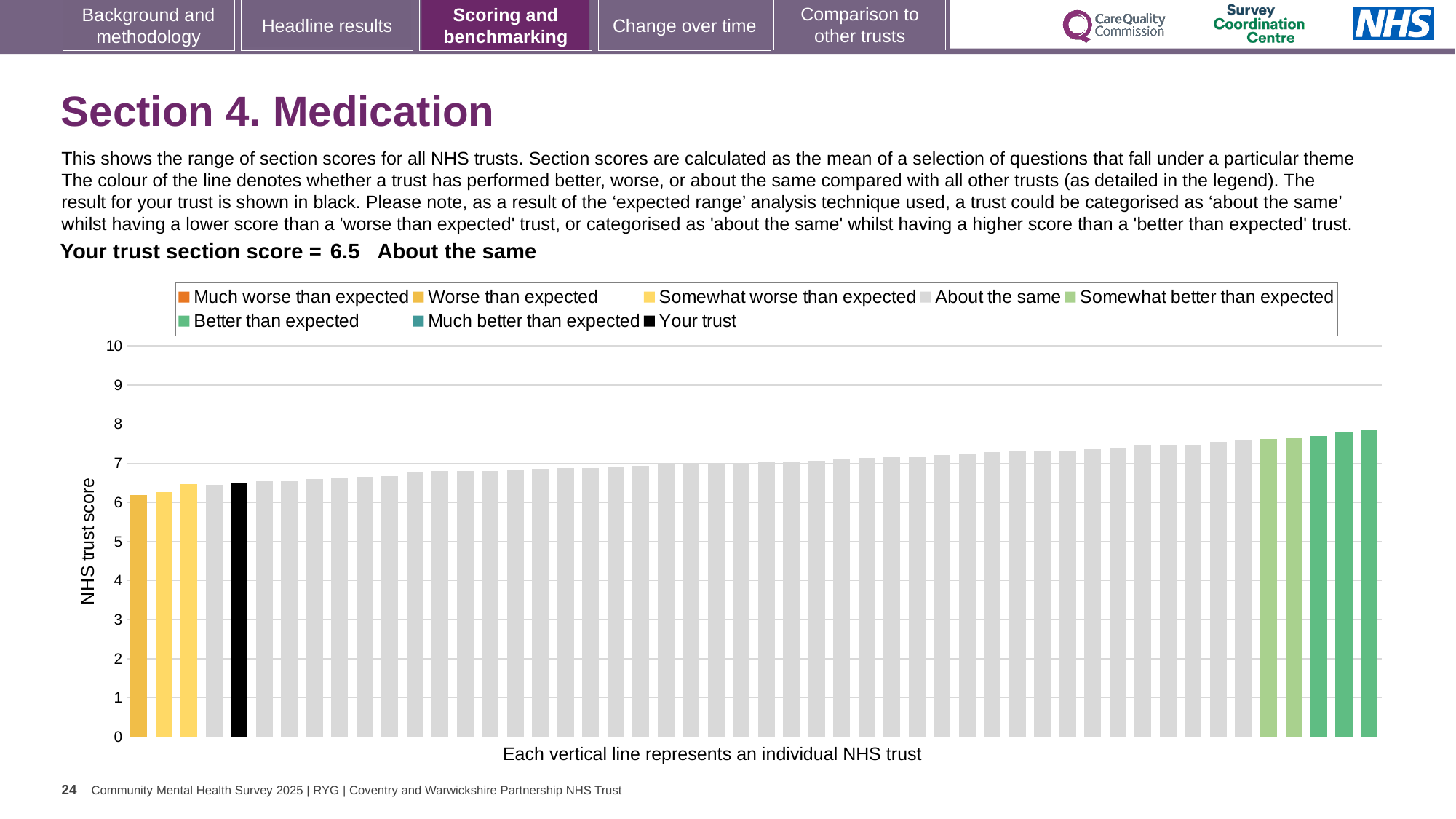
What kind of chart is shown on the slide? bar chart Is the value of the highest bar greater or less than 8? less How many bars are coloured yellow (worse than expected categories)? 3 How many bars are coloured dark green (Better than expected)? 3 What is your trust's section score for Medication? 6.5 Is the value of the lowest bar greater or less than 6? greater How many entries does the chart legend list? 8 Do the bar values rise or fall from left to right along the x axis? rise Is the value of the lowest bar greater or less than 7? less What does the caption below the x axis say each vertical line represents? an individual NHS trust Which performance category is your trust placed in for this section? About the same